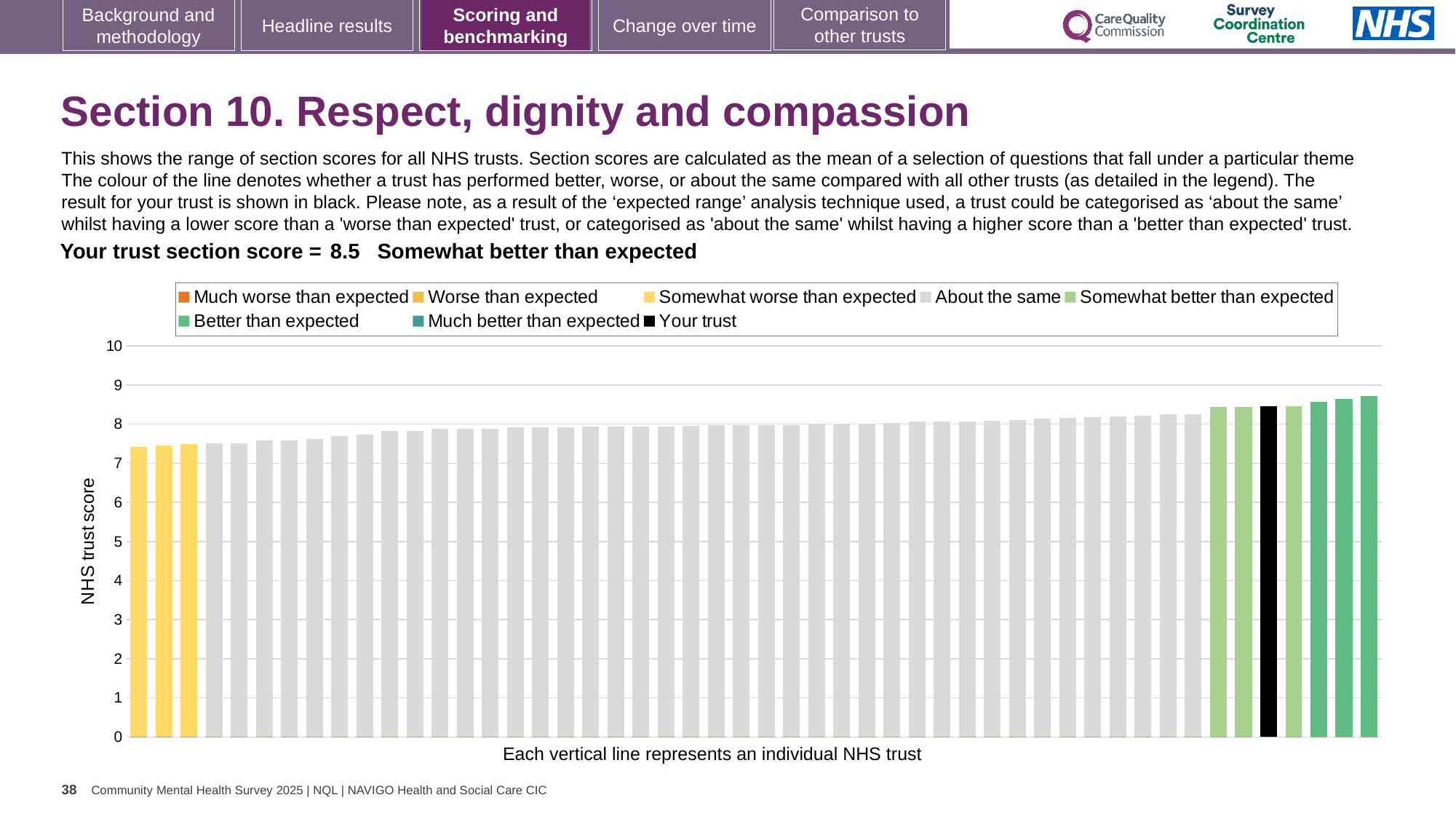
Is your trust's score greater or less than 8? greater What kind of chart is shown on the slide? bar chart How many bars in the chart are coloured black? 1 Is the black bar for your trust higher or lower than the leftmost bar in the chart? higher What colour is the bar representing your trust? black Is the value of the highest bar in the chart greater or less than 9? less How many entries does the chart legend list? 8 Do the bar values rise or fall from left to right across the chart? rise What is the section score for your trust shown on the slide? 8.5 What is the label on the vertical axis of the chart? NHS trust score Which category does the slide say your trust's section score falls into? Somewhat better than expected Is the value of the lowest bar in the chart greater or less than 7? greater